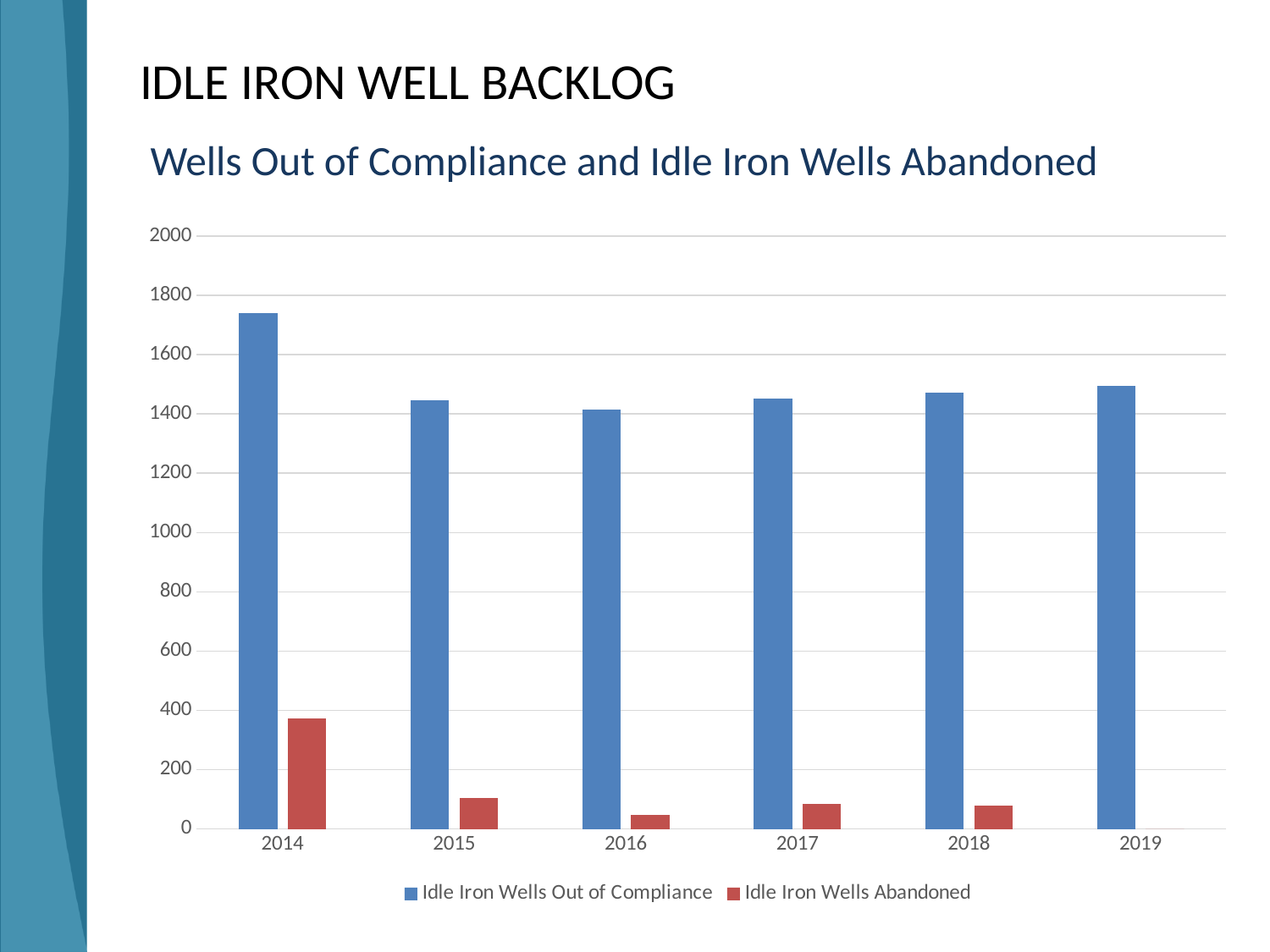
Is the value for Idle Iron Wells Abandoned in 2015 greater or less than 200? less Do the values for Idle Iron Wells Out of Compliance rise or fall from 2016 to 2019? rise Which year has the highest value for Idle Iron Wells Abandoned? 2014 How many series does the legend list? 2 Is the value for Idle Iron Wells Out of Compliance in 2014 greater or less than 1600? greater Which year has the highest value for Idle Iron Wells Out of Compliance? 2014 Is the value for Idle Iron Wells Abandoned in 2014 greater or less than 400? less What kind of chart is shown on the slide? bar chart How many years are shown on the x axis? 6 Which is larger: Idle Iron Wells Out of Compliance in 2014 or in 2019? 2014 What is the title of the chart? Wells Out of Compliance and Idle Iron Wells Abandoned